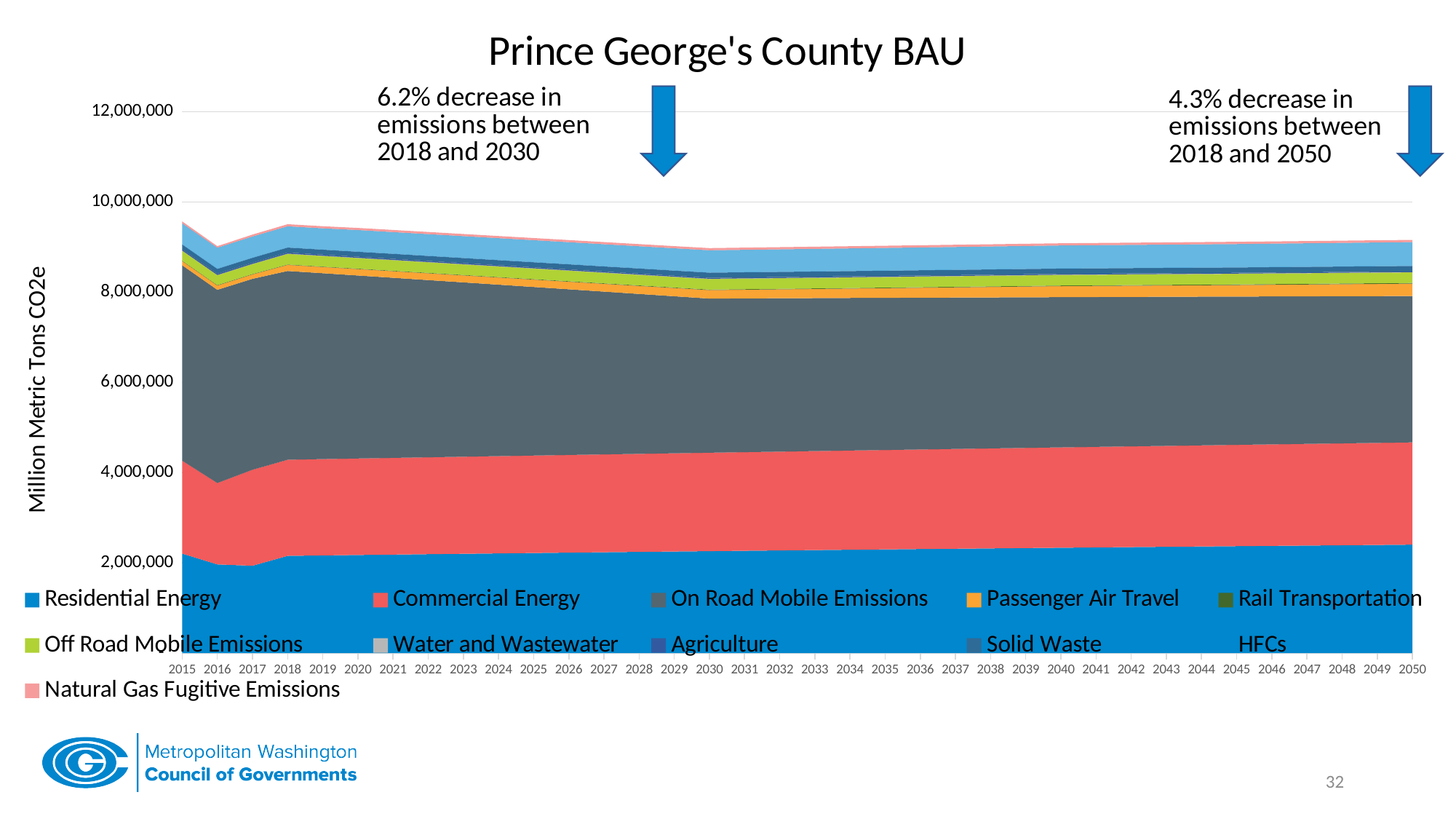
Which series occupies the largest band of the stacked area? On Road Mobile Emissions Does the Residential Energy band rise or fall between 2018 and 2050? rise Is the Residential Energy value in 2050 greater or less than 2,000,000? greater Which is larger in 2050, the Commercial Energy band or the Passenger Air Travel band? Commercial Energy Do total emissions rise or fall between 2018 and 2030? fall Is the total emissions value in 2015 greater or less than 10,000,000? less What kind of chart is shown on the slide? stacked area chart What is the label on the vertical axis? Million Metric Tons CO2e How many years are shown along the x axis? 36 What is the title of the chart? Prince George's County BAU How many series does the legend list? 11 Is the total emissions value in 2030 greater or less than 8,000,000? greater